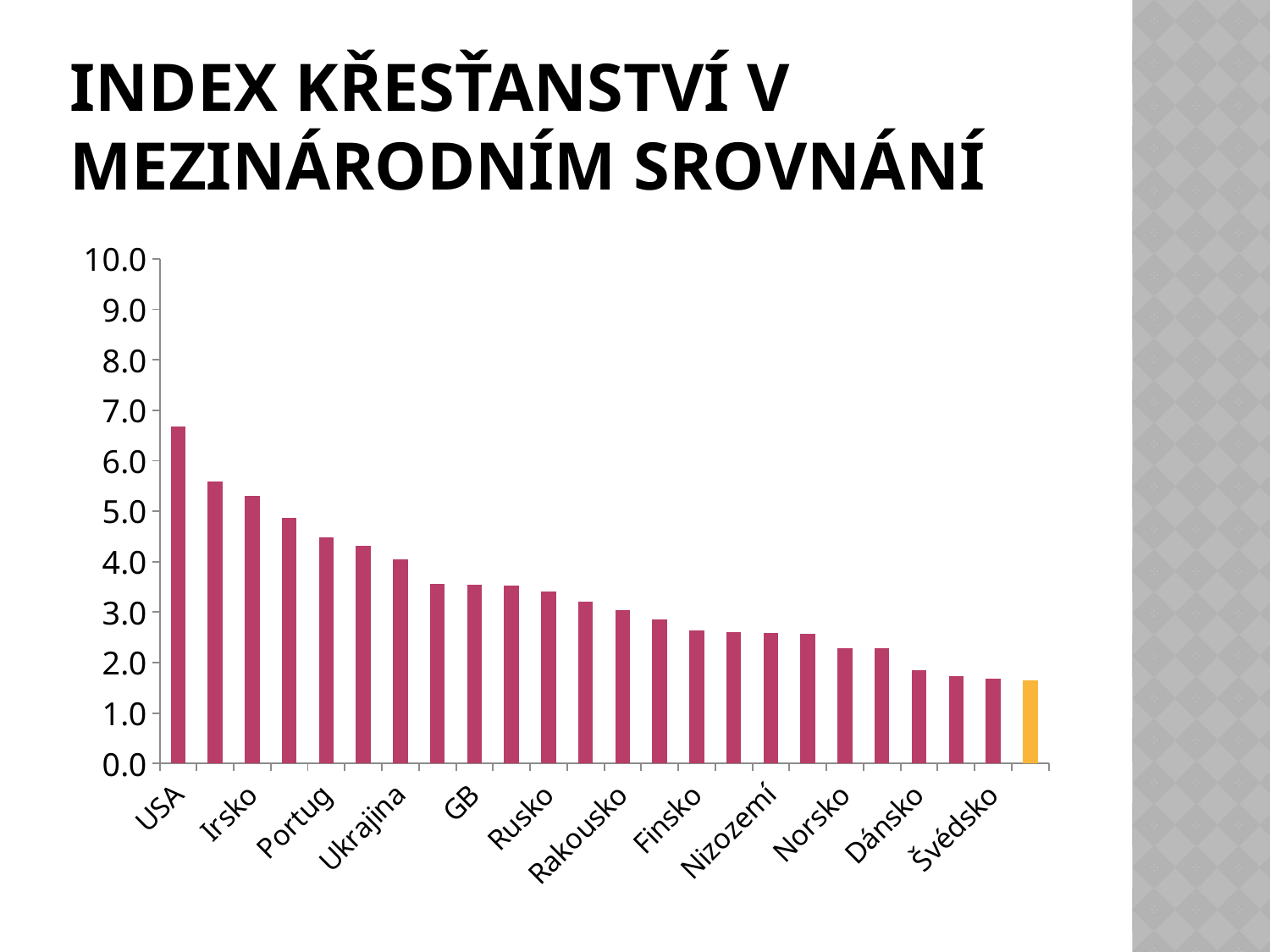
What kind of chart is shown on the slide? bar chart Is the value for Dánsko greater or less than 2.0? less Is the value for Finsko greater or less than 3.0? less Which country has the highest value in the chart? USA What colour is the last bar on the right, which differs from the others? yellow Is the value for Irsko greater or less than 5.0? greater Do the values rise or fall from left to right along the x axis? fall Which has a larger value, USA or Irsko? USA Which has a larger value, Rusko or Norsko? Rusko